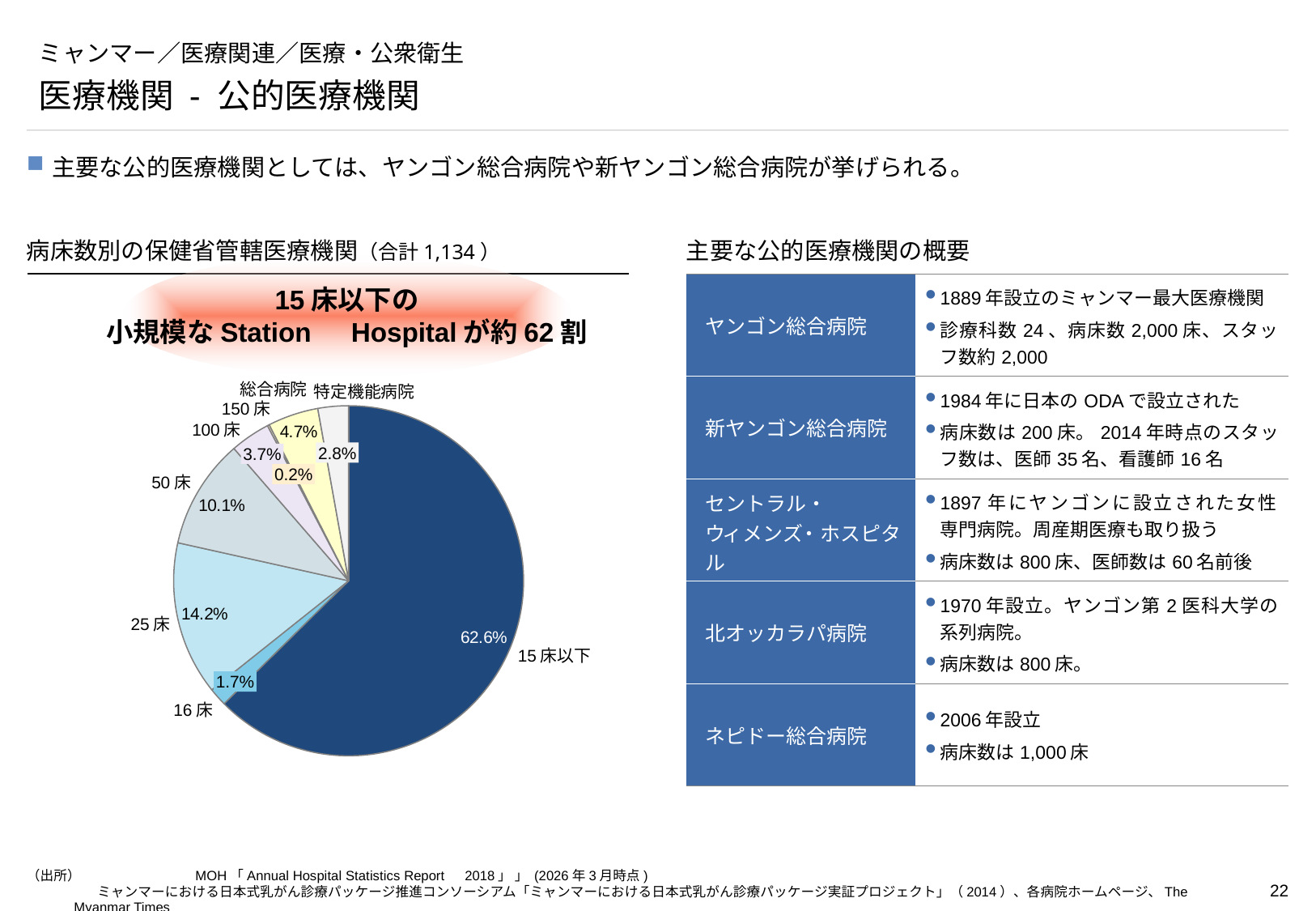
Which category has the largest slice in the pie chart? 15床以下 In the pie chart, what share do 特定機能病院 have? 2.8% In the pie chart, which is larger: the share for 25床 or the share for 50床? 25床 In the pie chart, what share do hospitals with 50 beds (50床) have? 10.1% In the pie chart, what share do hospitals with 15 beds or fewer (15床以下) have? 62.6% How many slices does the pie chart have? 8 Which category has the smallest slice in the pie chart? 150床 In the pie chart, what share do hospitals with 16 beds (16床) have? 1.7% What kind of chart is shown on the left of the slide? pie chart In the pie chart, what share do hospitals with 25 beds (25床) have? 14.2% What is the difference between the share for 15床以下 and the share for 25床 in the pie chart? 48.4% In the pie chart, what share do 総合病院 (general hospitals) have? 4.7%